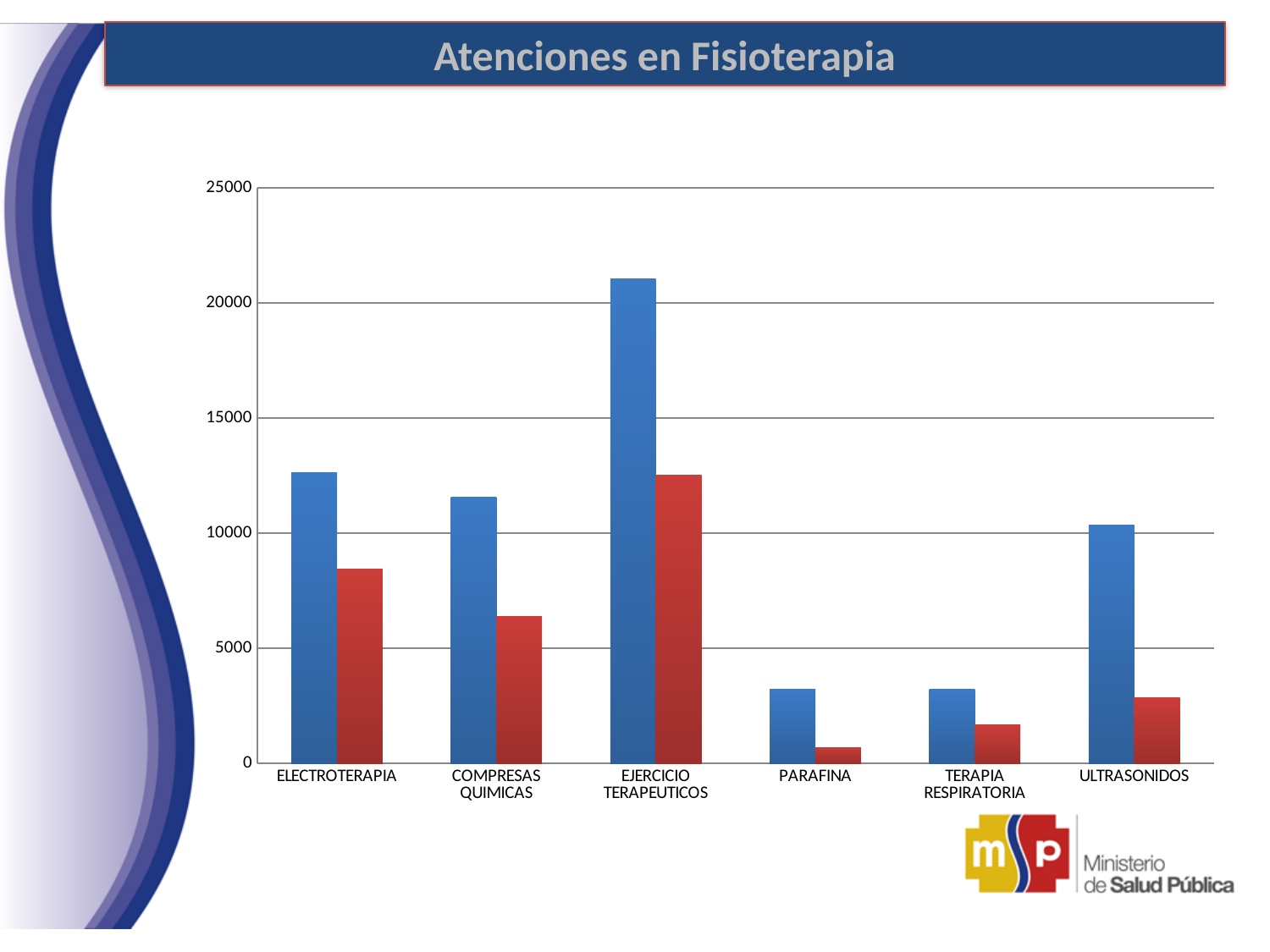
What kind of chart is shown on the slide? bar chart Which is larger, the blue bar for ELECTROTERAPIA or the blue bar for COMPRESAS QUIMICAS? ELECTROTERAPIA Which category has the tallest red bar? EJERCICIO TERAPEUTICOS How many categories are shown on the x axis of the chart? 6 Which is larger, the red bar for ULTRASONIDOS or the red bar for TERAPIA RESPIRATORIA? ULTRASONIDOS What is the title of the slide containing the chart? Atenciones en Fisioterapia Is the blue bar for EJERCICIO TERAPEUTICOS greater or less than 20000? greater Which category has the tallest blue bar? EJERCICIO TERAPEUTICOS Is the red bar for EJERCICIO TERAPEUTICOS greater or less than 10000? greater Is the red bar for ELECTROTERAPIA greater or less than 10000? less Which category has the shortest red bar? PARAFINA